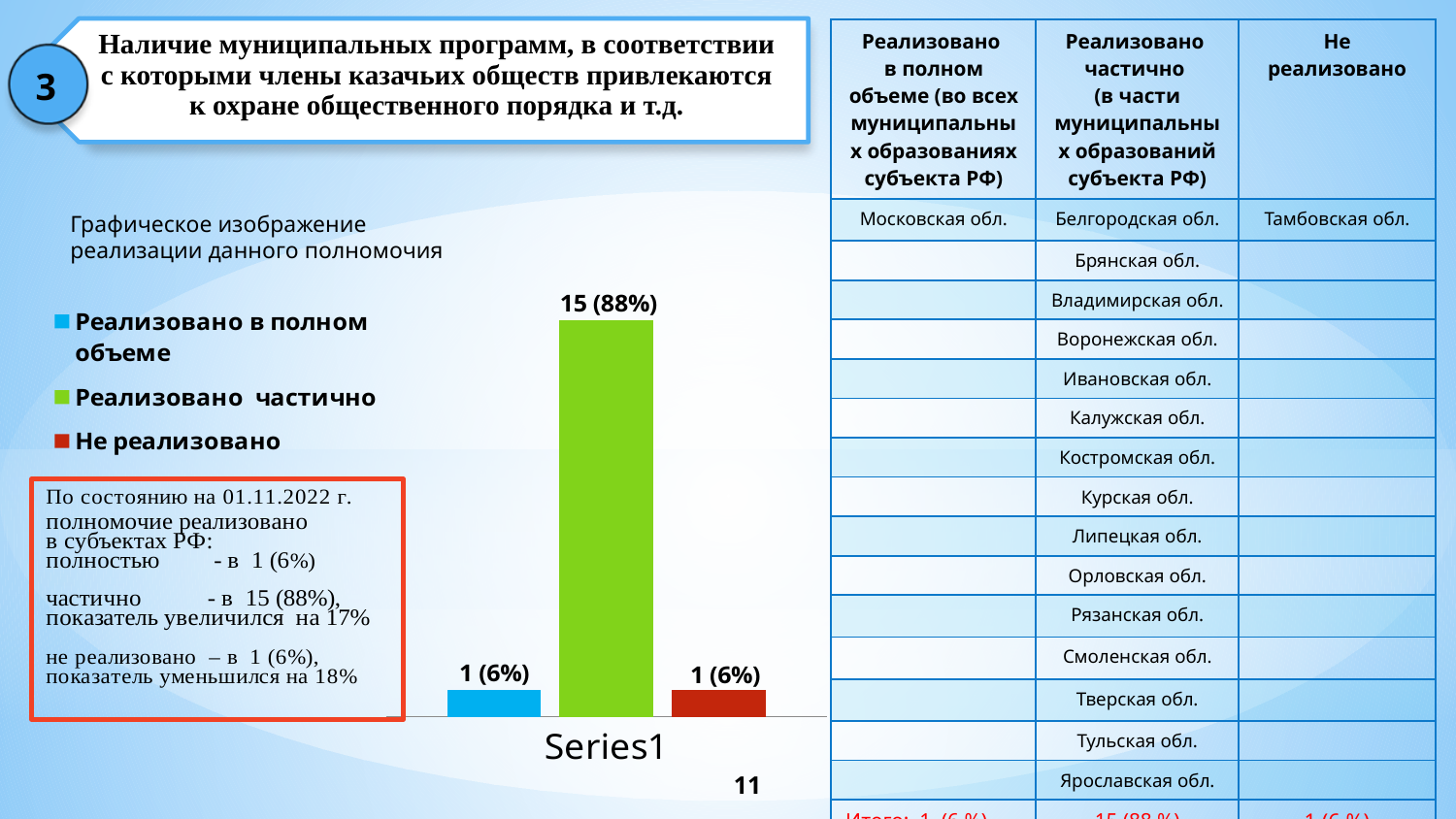
What kind of chart is shown on the slide? bar chart What is the category label shown on the x axis of the chart? Series1 What is the data label on the bar for "Реализовано частично"? 15 (88%) What is the data label on the bar for "Не реализовано"? 1 (6%) What is the data label on the bar for "Реализовано в полном объеме"? 1 (6%) Which legend entry has the tallest bar? Реализовано частично What is the total of the three bar counts in the chart? 17 How many series does the legend list? 3 Which is larger, the value for "Реализовано частично" or the value for "Реализовано в полном объеме"? Реализовано частично How many bars are plotted in the chart? 3 What is the difference in count between "Реализовано частично" and "Не реализовано"? 14 What colour is the bar for "Реализовано частично"? green